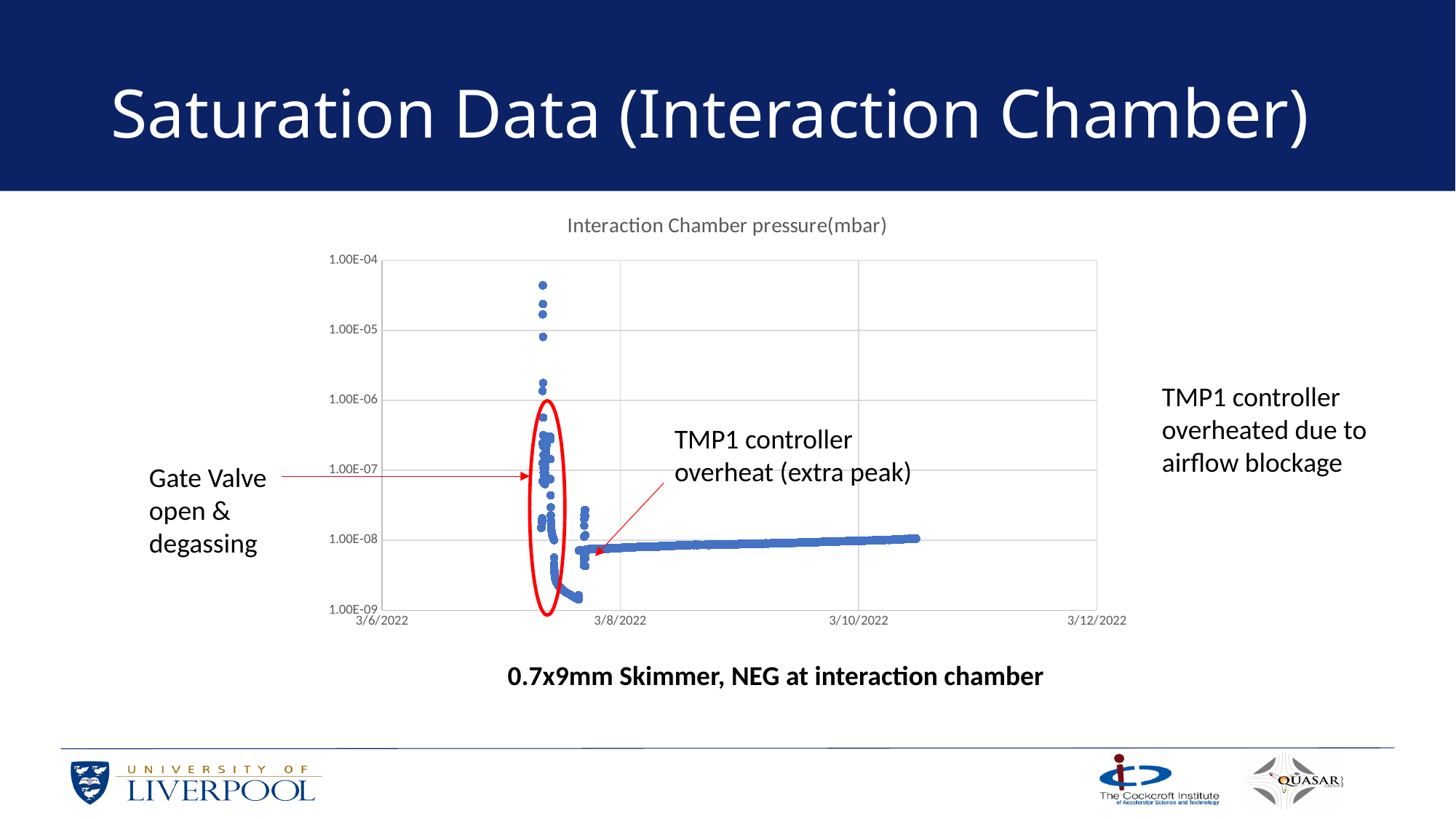
What is the title of the chart? Interaction Chamber pressure(mbar) How many date labels are shown on the x axis? 4 Along the long band of points from 3/8/2022 onward, does the pressure rise or fall over time? rise Is the pressure in the long flat band of points after 3/8/2022 greater or less than 1.00E-07? less Is the highest plotted pressure value greater or less than 1.00E-05? greater Is the highest plotted pressure value greater or less than 1.00E-04? less What does the annotation pointing to the red-circled cluster of points say? Gate Valve open & degassing What kind of chart is shown on the slide? scatter chart